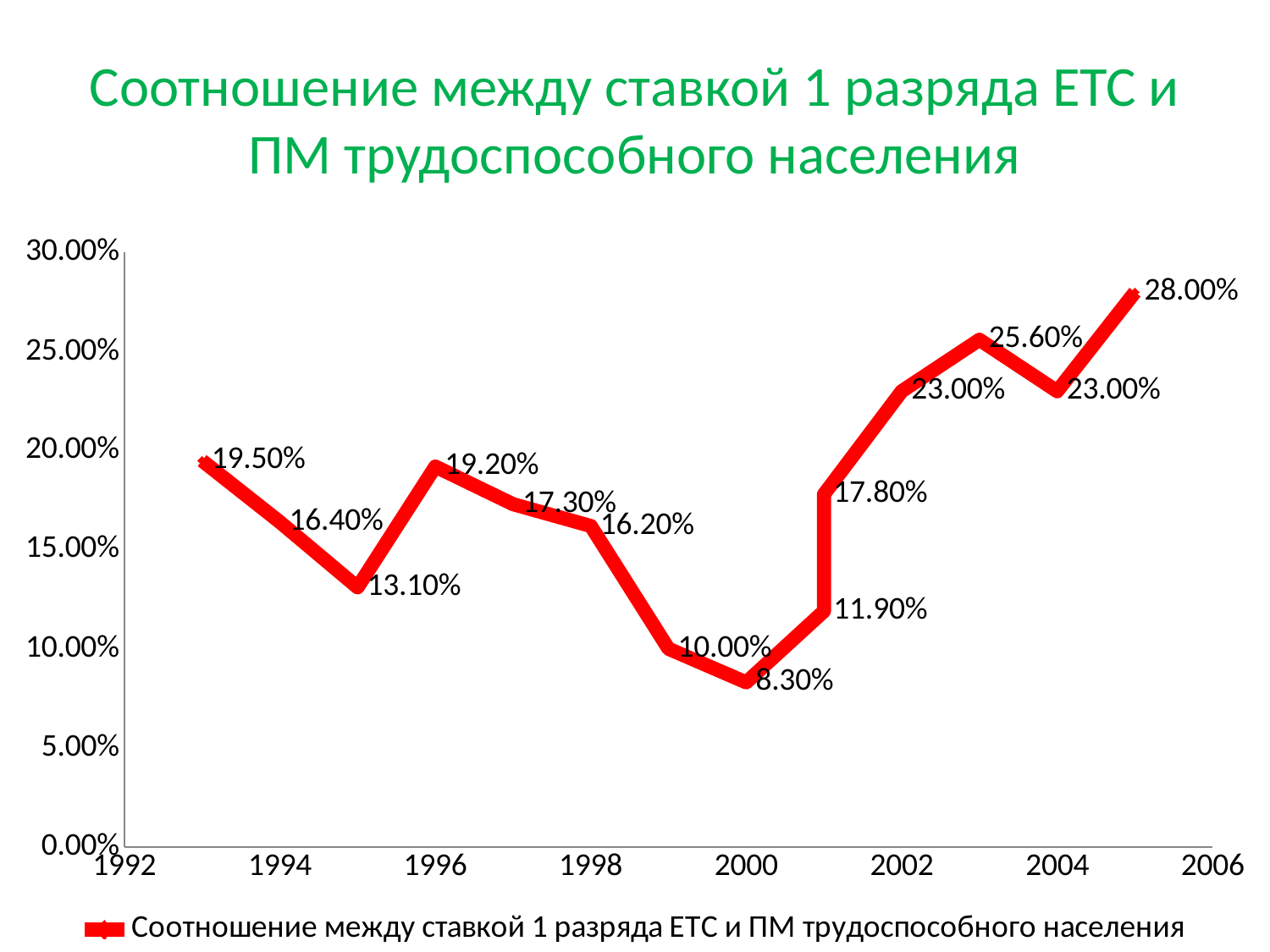
What is the difference between the values for 1998 and 2000? 7.90% What kind of chart is shown on the slide? line chart What is the highest value plotted on the chart? 28.00% Is the value for 2004 greater or less than 20.00%? greater What is the value for 1998? 16.20% How many series does the legend list? 1 Does the line rise or fall between 1996 and 2000? fall Which year has the larger value, 1996 or 1998? 1996 What is the value of the last data point on the line (2005)? 28.00% What is the value for 1996? 19.20% In which year does the line reach its lowest value? 2000 What is the value for 2000? 8.30%